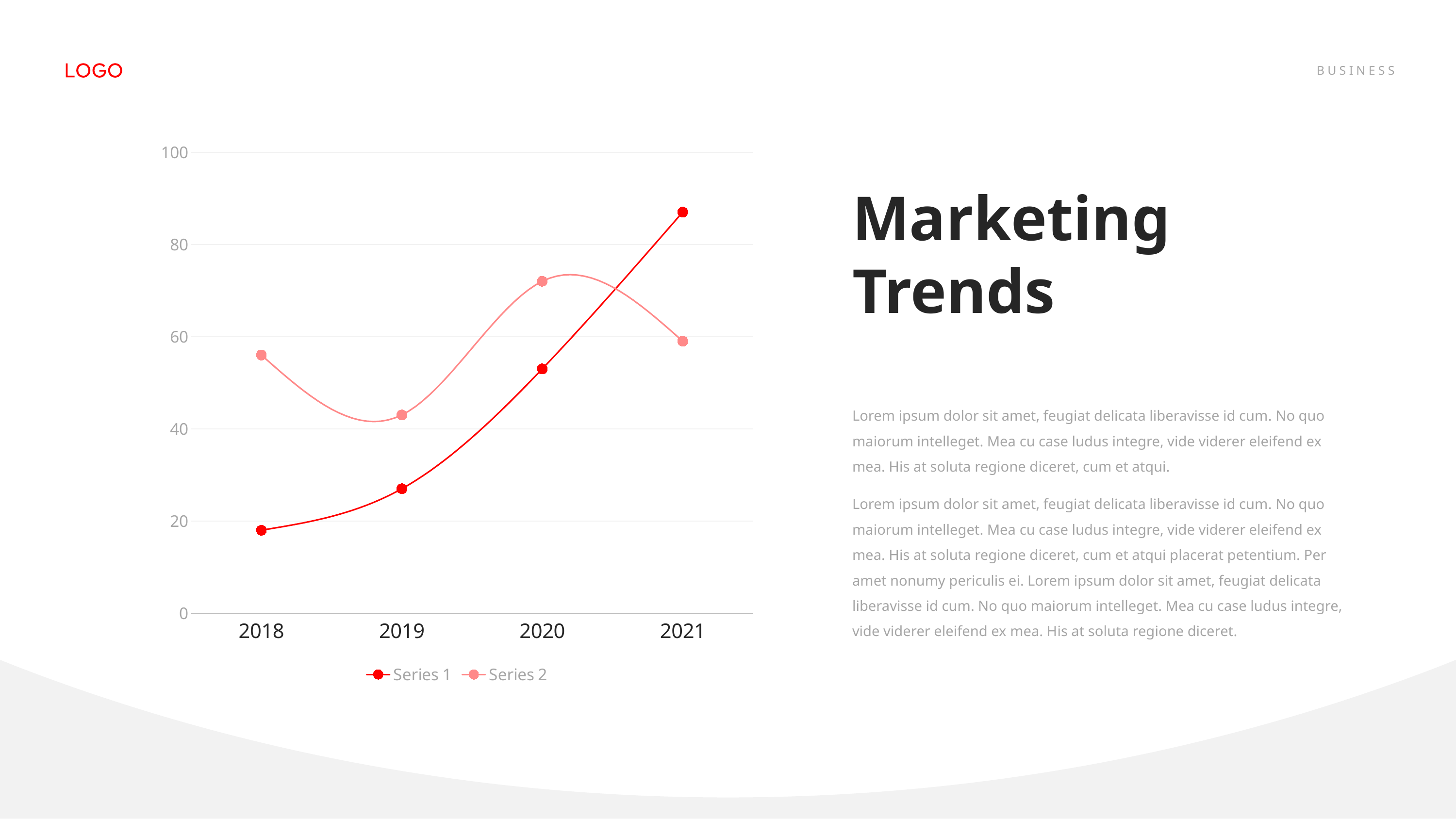
Is the value for Series 1 in 2021 greater or less than 80? greater How many years are shown on the x axis? 4 Is the value for Series 2 in 2020 greater or less than 60? greater Is the value for Series 1 in 2018 greater or less than 20? less In which year does Series 2 have its lowest value? 2019 How many series does the legend list? 2 In 2018, which series has the larger value, Series 1 or Series 2? Series 2 What kind of chart is shown on the slide? line chart Which series is drawn in the lighter pink colour? Series 2 In which year does Series 1 reach its highest value? 2021 Does Series 1 rise or fall from 2018 to 2021? rise